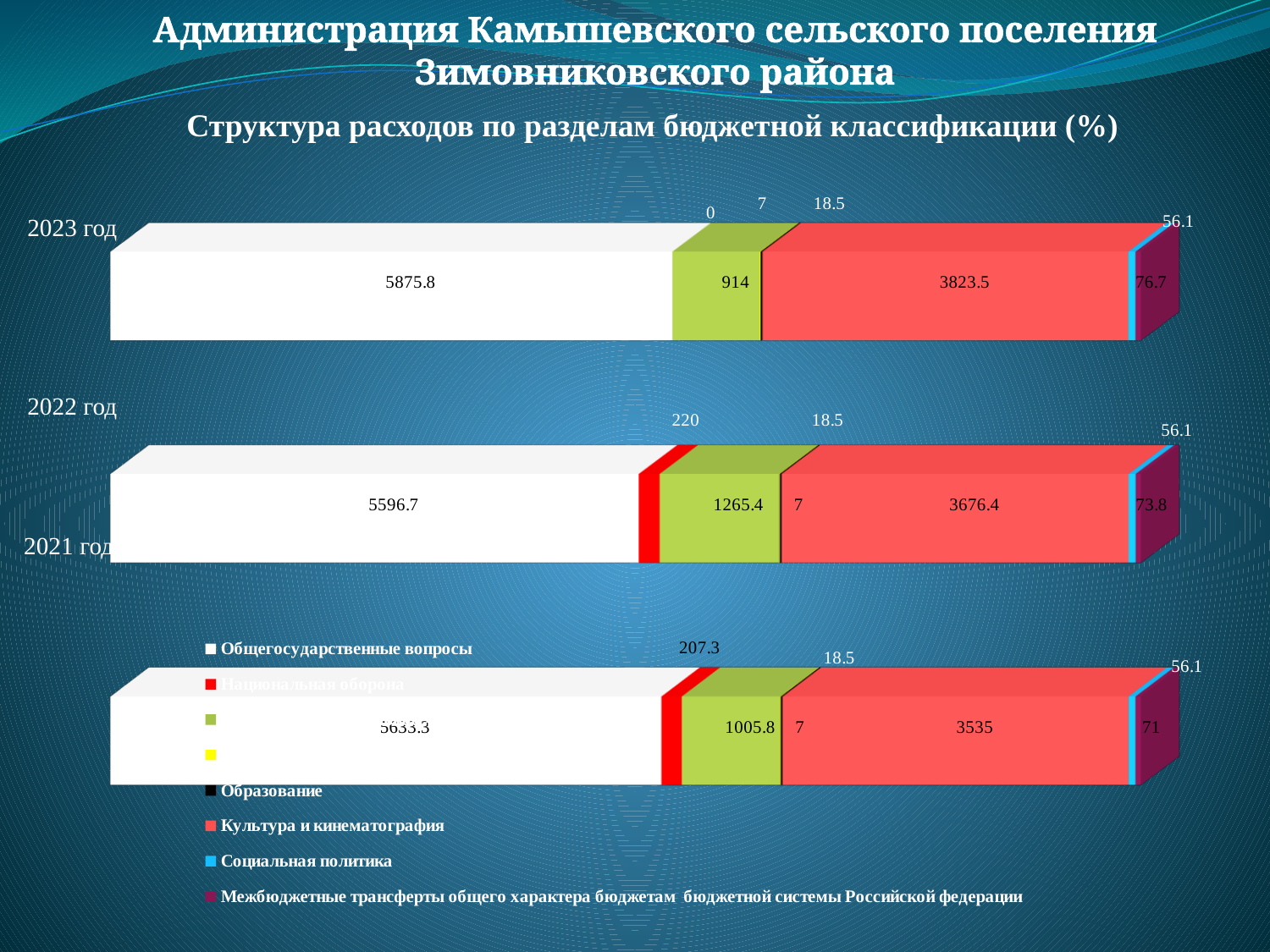
What is the value for Культура и кинематография in 2021? 3535 Does the value for Культура и кинематография rise or fall from 2021 to 2023? Rises What is the value for Общегосударственные вопросы in 2022? 5596.7 Which series has the largest segment in the 2023 bar? Общегосударственные вопросы What is the value for Национальная оборона in 2022? 220 What kind of chart is shown on the slide? Stacked bar chart How many series does the legend list? 8 What is the difference between Культура и кинематография in 2023 (3823.5) and in 2021 (3535)? 288.5 What is the value for Общегосударственные вопросы in 2023? 5875.8 What is the value for Межбюджетные трансферты общего характера бюджетам бюджетной системы Российской федерации in 2023? 56.1 How many years (bars) does the chart show? 3 Which is larger: Общегосударственные вопросы in 2023 or in 2022? 2023